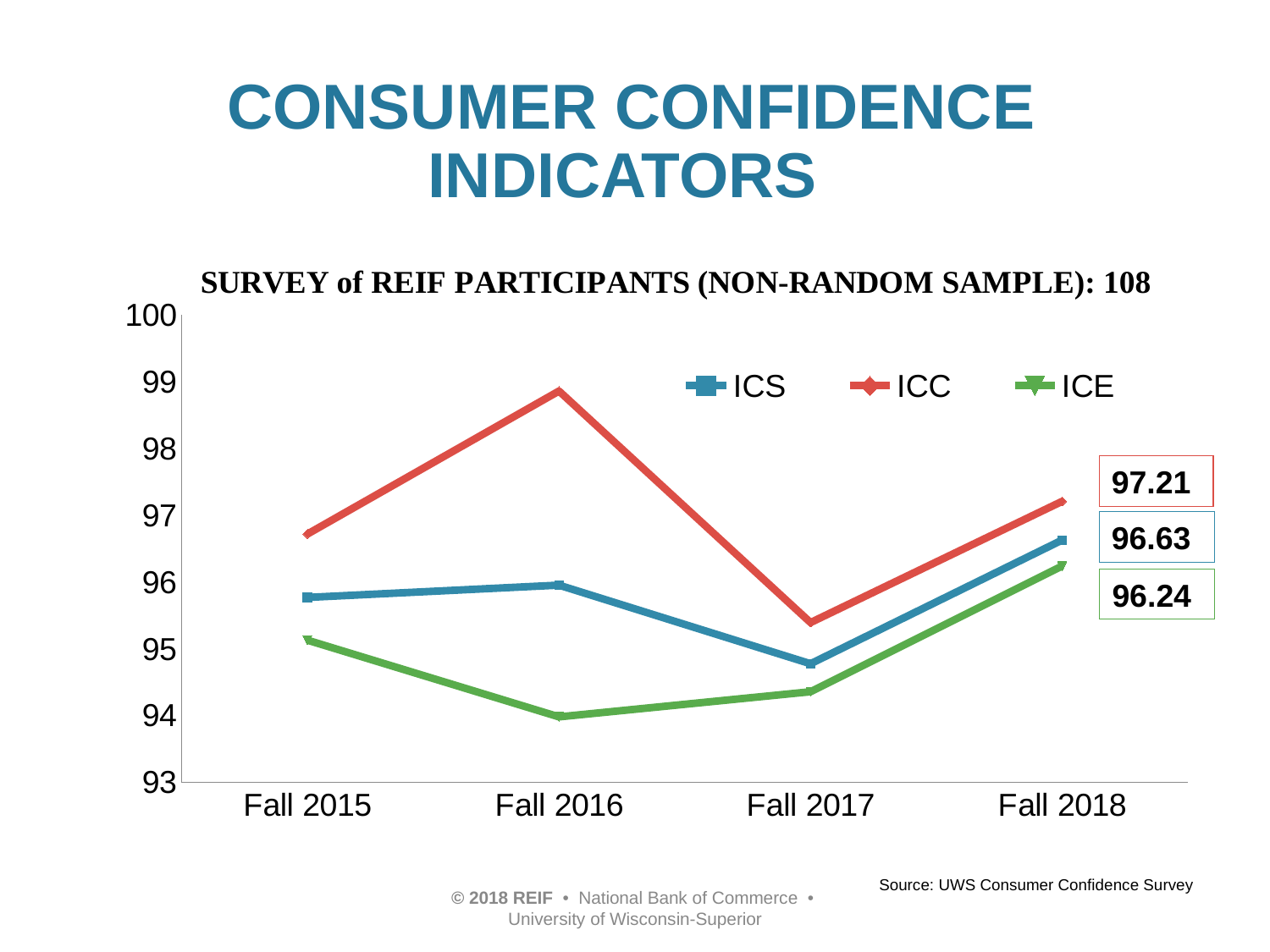
Which series has the lowest value in Fall 2016? ICE How many series does the legend list? 3 What is the ICS value for Fall 2018? 96.63 How many time points are shown on the x axis? 4 Which series has the highest value in Fall 2016? ICC What is the ICE value for Fall 2018? 96.24 Is the ICC value for Fall 2016 greater or less than 98? greater What is the difference between the ICC and ICE values for Fall 2018? 0.97 What is the ICC value for Fall 2018? 97.21 Is the ICE value for Fall 2017 greater or less than 95? less What kind of chart is shown on the slide? line chart Does the ICE series rise or fall from Fall 2017 to Fall 2018? rise